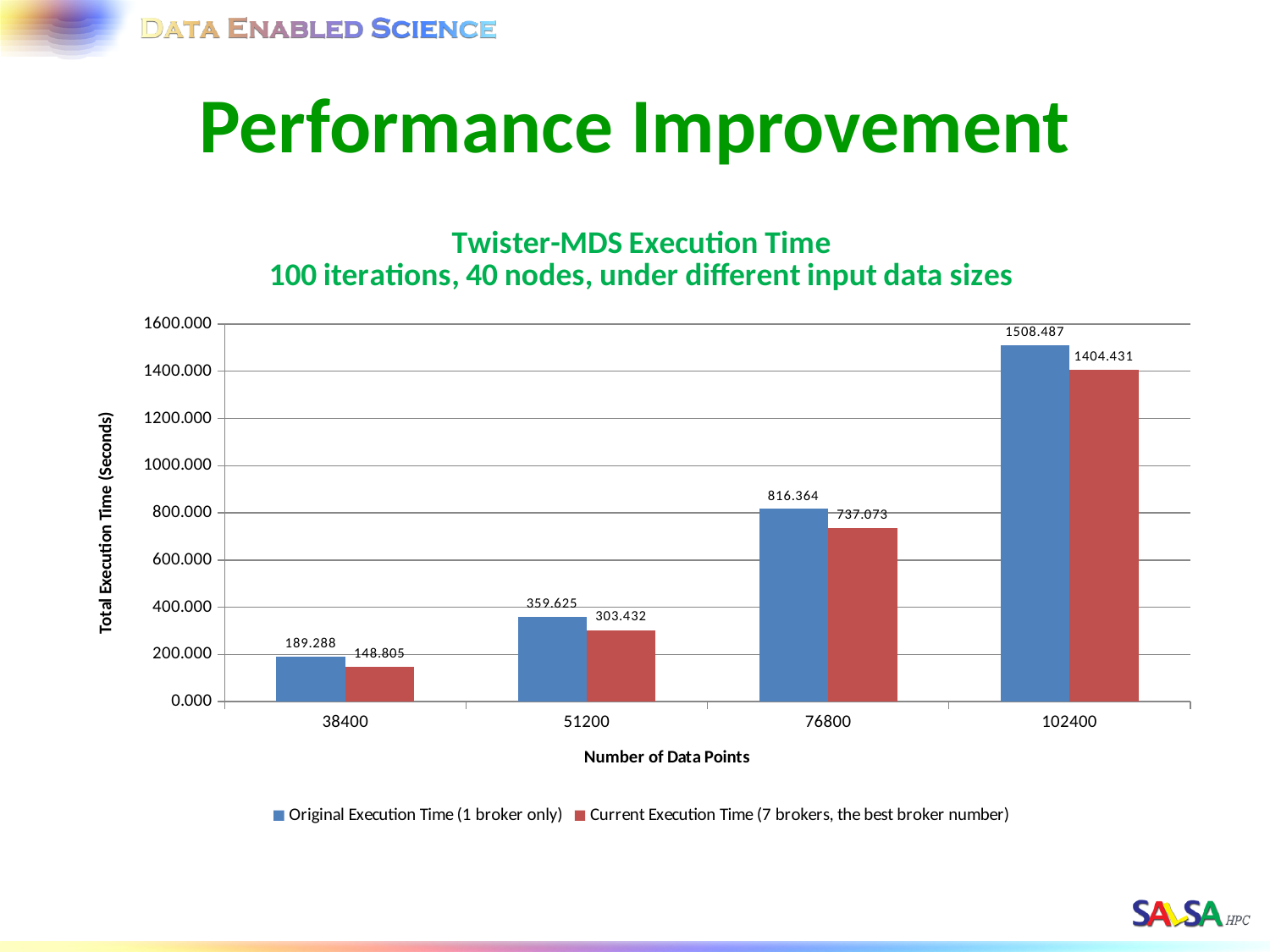
What kind of chart is shown on the slide? Bar chart What is the Original Execution Time (1 broker only) for 38400 data points? 189.288 What is the Original Execution Time (1 broker only) for 51200 data points? 359.625 What is the difference between the Original and Current Execution Time for 102400 data points? 104.056 Which number of data points has the lowest Current Execution Time? 38400 What is the Current Execution Time (7 brokers) for 76800 data points? 737.073 For 76800 data points, which is larger: the Original Execution Time or the Current Execution Time? Original Execution Time What is the difference between the Original and Current Execution Time for 38400 data points? 40.483 How many data point sizes are shown on the x axis? 4 How many series does the legend list? 2 Which number of data points has the highest Original Execution Time? 102400 What is the Current Execution Time (7 brokers) for 102400 data points? 1404.431